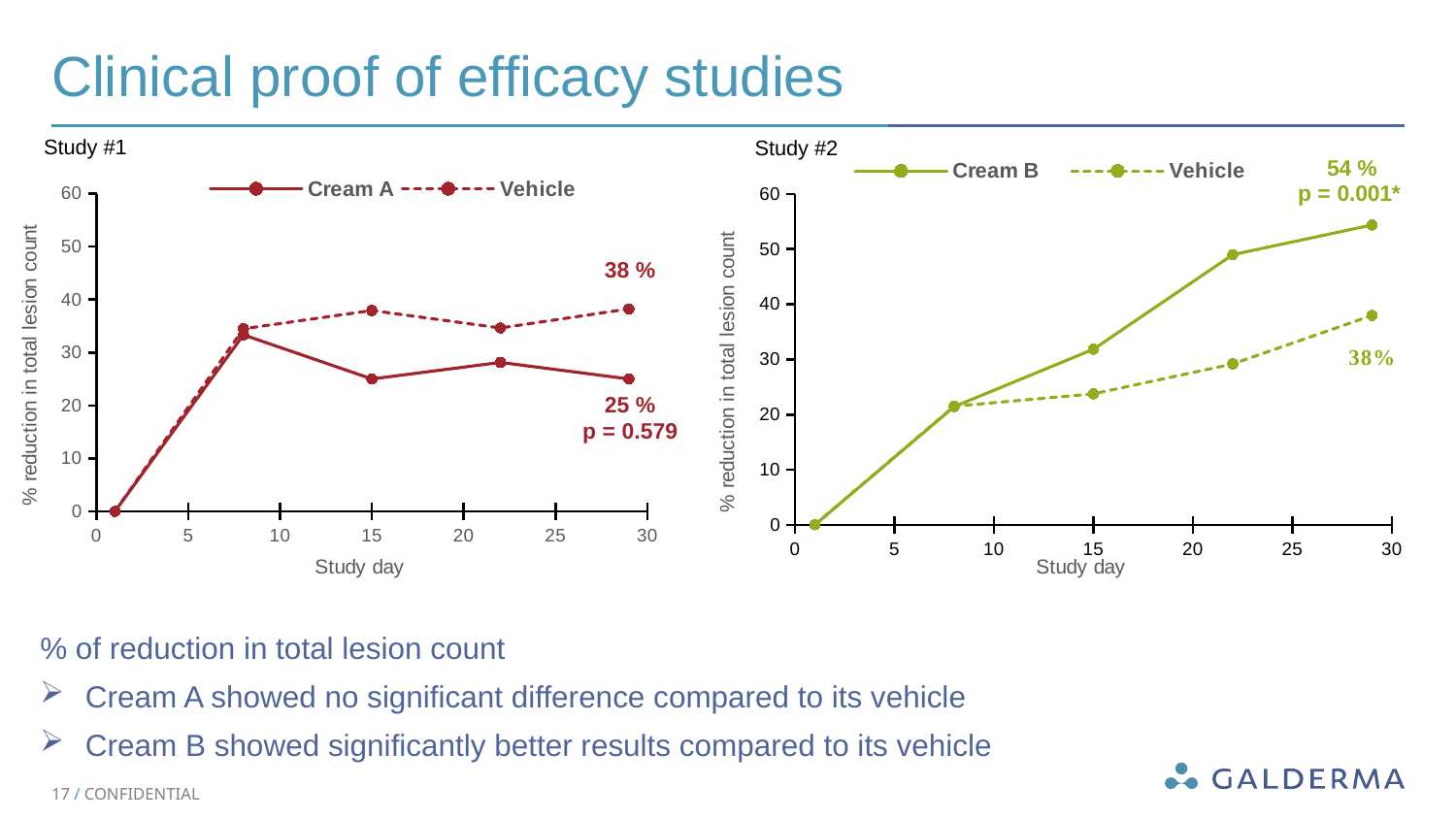
In the Study #2 chart, is the value for Cream B at day 22 greater or less than 40? greater In the Study #1 chart, what is the difference between the final values of Vehicle and Cream A at day 29? 13 % How many series does the legend of the Study #2 chart list? 2 In the Study #2 chart, which series has the higher value at day 29, Cream B or Vehicle? Cream B In the Study #2 chart, what is the final % reduction in total lesion count for Cream B at day 29? 54 % In the Study #2 chart, what is the difference between the final values of Cream B and Vehicle at day 29? 16 % In the Study #1 chart, what is the final % reduction in total lesion count for Cream A at day 29? 25 % In the Study #1 chart, which series has the higher value at day 29, Cream A or Vehicle? Vehicle In the Study #1 chart, what is the final % reduction in total lesion count for Vehicle at day 29? 38 % In the Study #2 chart, what is the final % reduction in total lesion count for Vehicle at day 29? 38% What kind of chart is the Study #1 chart? Line chart In the Study #1 chart, is the value for Cream A at day 15 greater or less than 30? less